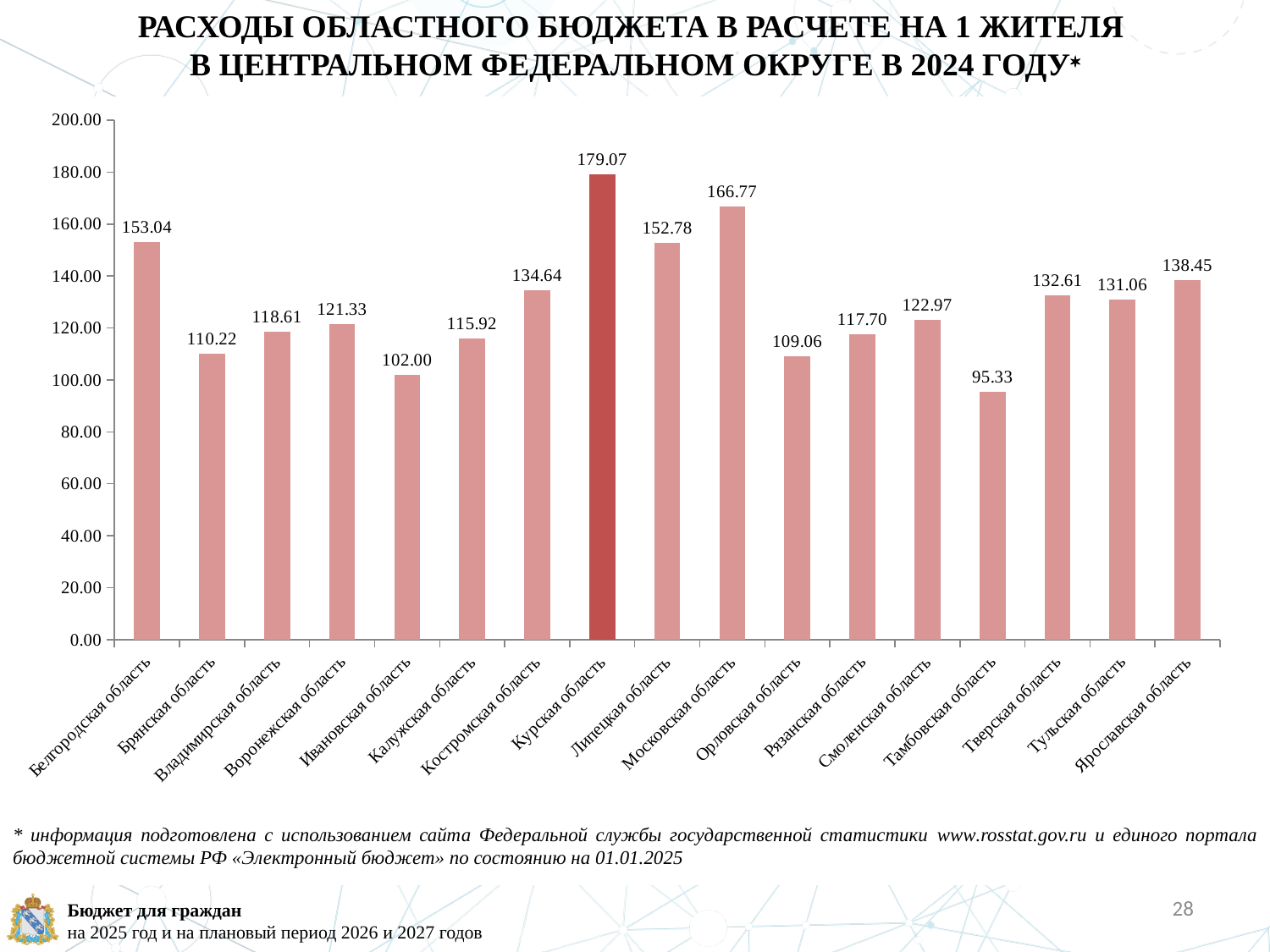
Which region has the highest value? Курская область Is the value for Ивановская область greater or less than 120.00? less How many regions are shown on the chart? 17 What is the value for Московская область? 166.77 What is the value for Тамбовская область? 95.33 What is the difference between the values for Белгородская область and Липецкая область? 0.26 Which region has the lowest value? Тамбовская область Which is larger, the value for Тверская область or the value for Тульская область? Тверская область What is the difference between the values for Курская область and Московская область? 12.30 What is the value for Курская область? 179.07 What kind of chart is shown on the slide? bar chart Which bar is highlighted in a darker red colour than the others? Курская область